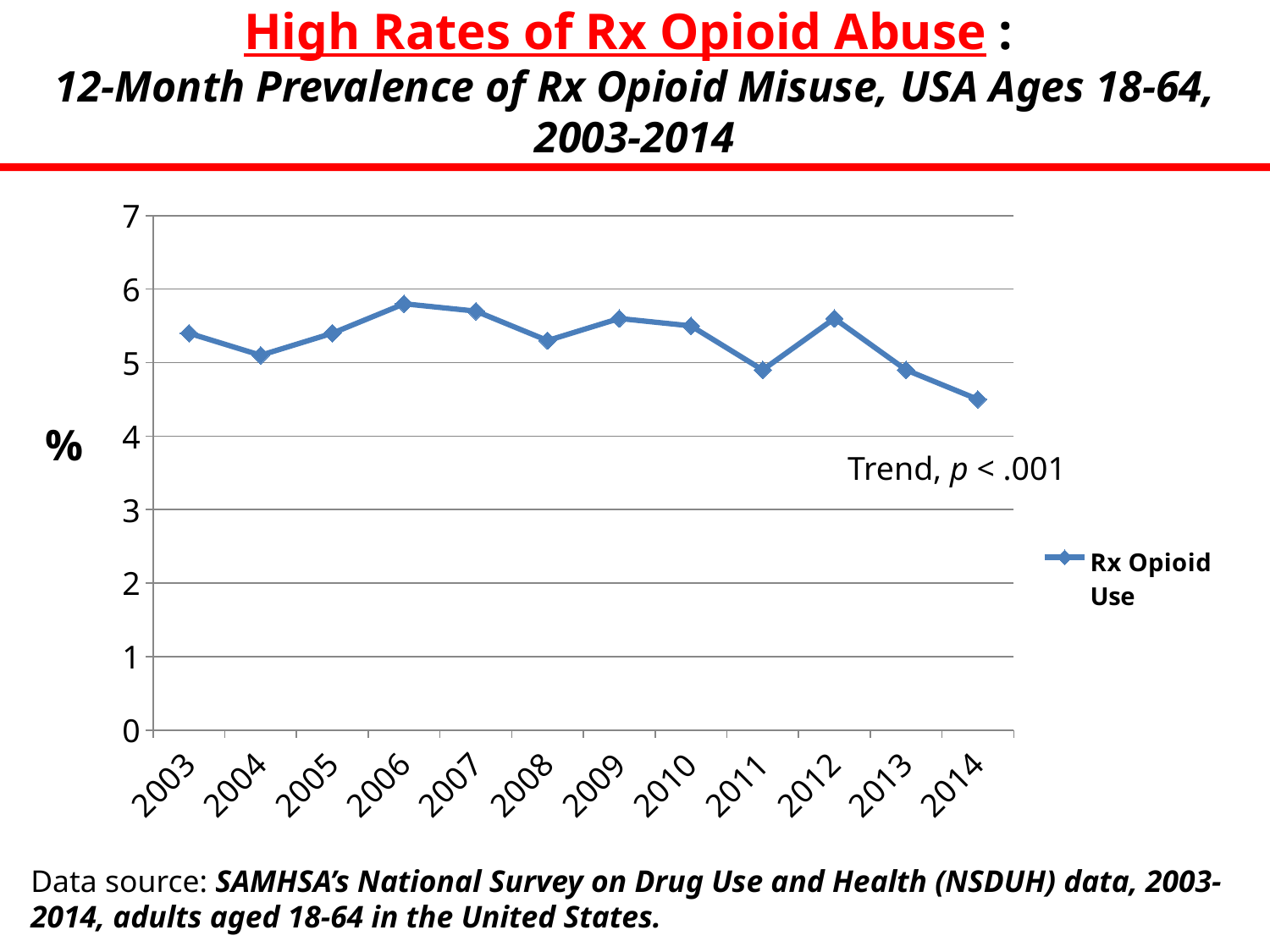
What is the name of the series shown in the legend? Rx Opioid Use Which is larger, the value for 2004 or the value for 2012? 2012 Which is larger, the value for 2006 or the value for 2014? 2006 Overall, does the prevalence rise or fall from 2003 to 2014? fall How many years (data points) are plotted on the x axis? 12 Is the value for 2006 greater or less than 5? greater Is the value for 2014 greater or less than 5? less Which year has the lowest prevalence of Rx opioid misuse? 2014 Is the value for 2003 greater or less than 6? less What kind of chart is shown on the slide? line chart How many series does the legend list? 1